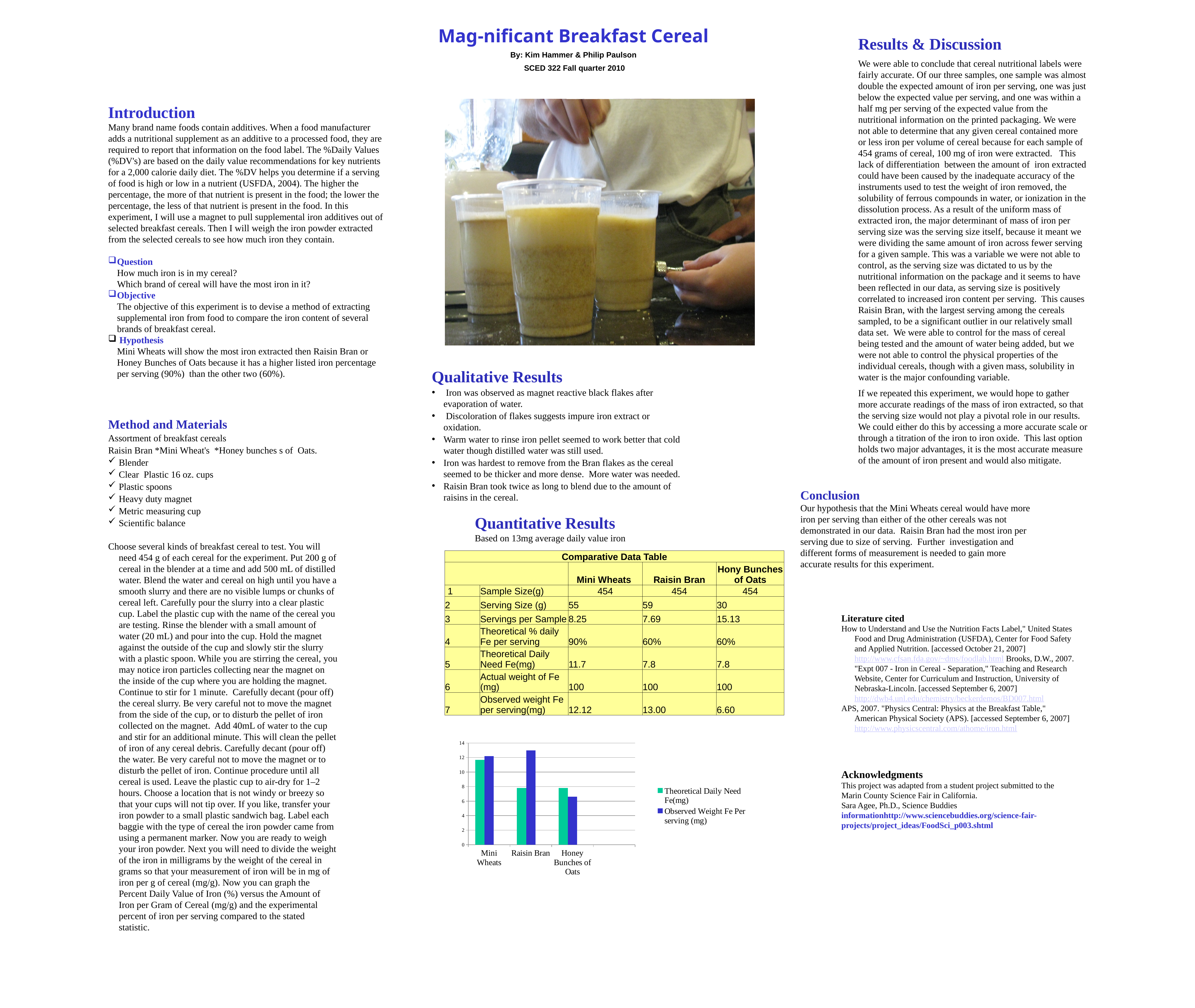
What kind of chart is shown at the bottom of the Quantitative Results section? bar chart For Raisin Bran, which is larger in the bar chart: the Theoretical Daily Need Fe(mg) or the Observed Weight Fe Per serving (mg)? Observed Weight Fe Per serving (mg) How many cereal categories are shown on the x axis of the bar chart? 3 How many series does the legend of the bar chart list? 2 In the bar chart, is the Theoretical Daily Need Fe(mg) for Mini Wheats greater or less than 10? greater Which colour represents the Observed Weight Fe Per serving (mg) series in the bar chart? blue In the bar chart, is the Observed Weight Fe Per serving for Raisin Bran greater or less than 12? greater According to the Comparative Data Table, what is the Observed weight Fe per serving (mg) for Raisin Bran plotted in the bar chart? 13.00 Which cereal has the highest Theoretical Daily Need Fe(mg) in the bar chart? Mini Wheats Which cereal has the lowest Observed Weight Fe Per serving (mg) in the bar chart? Honey Bunches of Oats Which cereal has the highest Observed Weight Fe Per serving (mg) in the bar chart? Raisin Bran In the bar chart, is the Observed Weight Fe Per serving for Honey Bunches of Oats greater or less than 8? less